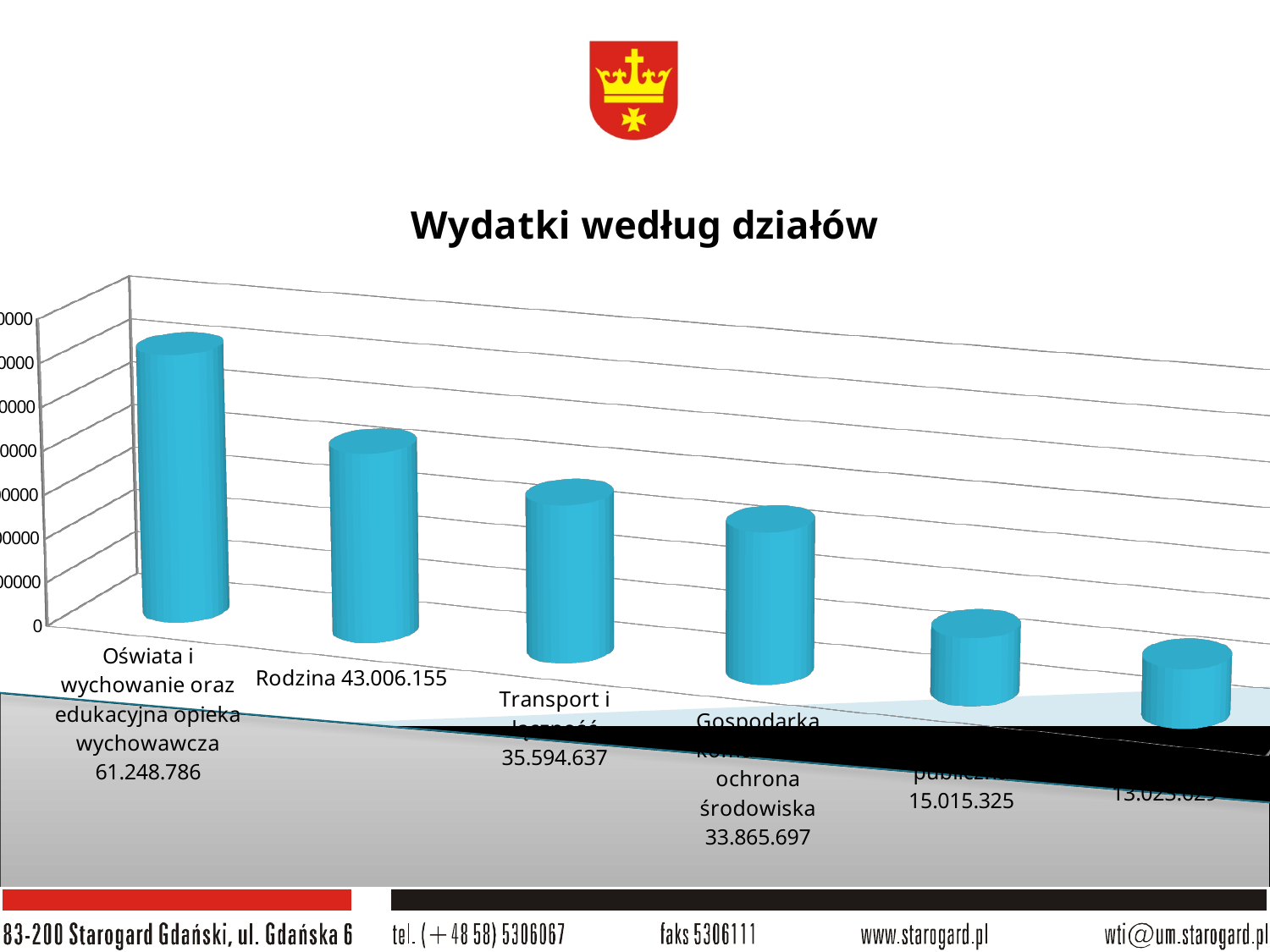
What is the value of the fourth bar from the left (Gospodarka ... ochrona środowiska)? 33.865.697 What is the value for Transport i łączność? 35.594.637 What is the title of the chart? Wydatki według działów Which is larger, the value for Rodzina or the value for Transport i łączność? Rodzina What kind of chart is shown on the slide? bar chart Do the bar values rise or fall from left to right along the x axis? fall How many bars does the chart show? 6 What is the value for Rodzina? 43.006.155 What is the value for Oświata i wychowanie oraz edukacyjna opieka wychowawcza? 61.248.786 Which category has the highest value? Oświata i wychowanie oraz edukacyjna opieka wychowawcza What is the difference between the value for Rodzina and the value for Transport i łączność? 7.411.518 What is the difference between the value for Oświata i wychowanie oraz edukacyjna opieka wychowawcza and the value for Rodzina? 18.242.631